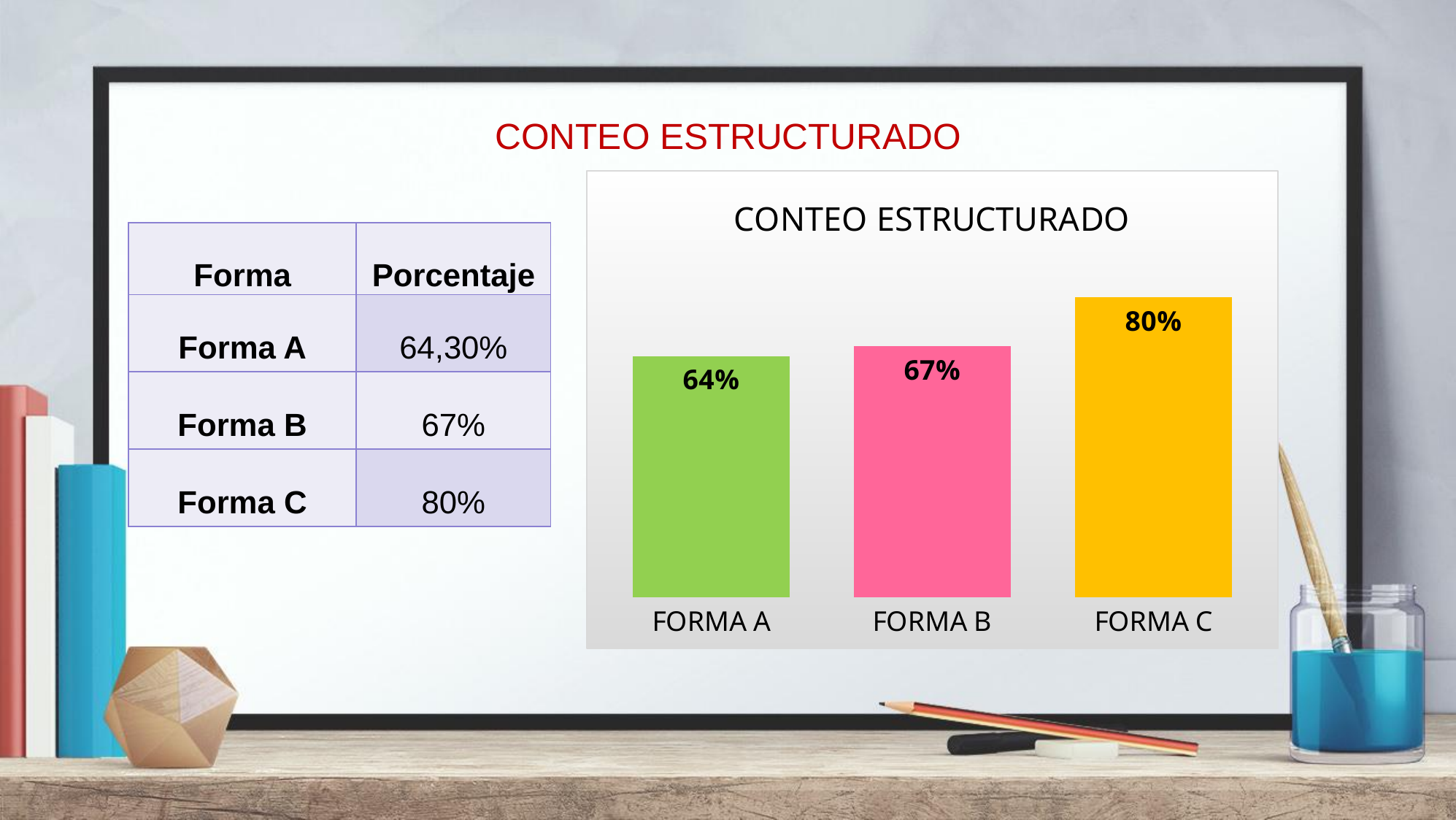
Which is larger in the chart, the value for FORMA B or the value for FORMA C? FORMA C What is the value shown for FORMA C in the chart? 80% What is the value shown for FORMA B in the chart? 67% What kind of chart is shown on the slide? Bar chart How many categories are plotted in the chart? 3 Which category has the highest value in the chart? FORMA C What is the value shown for FORMA A in the chart? 64% What is the title of the chart? CONTEO ESTRUCTURADO What is the difference between the values for FORMA C and FORMA A in the chart? 16% Which category has the lowest value in the chart? FORMA A Do the values rise or fall from FORMA A to FORMA C in the chart? Rise What is the difference between the values for FORMA B and FORMA A in the chart? 3%